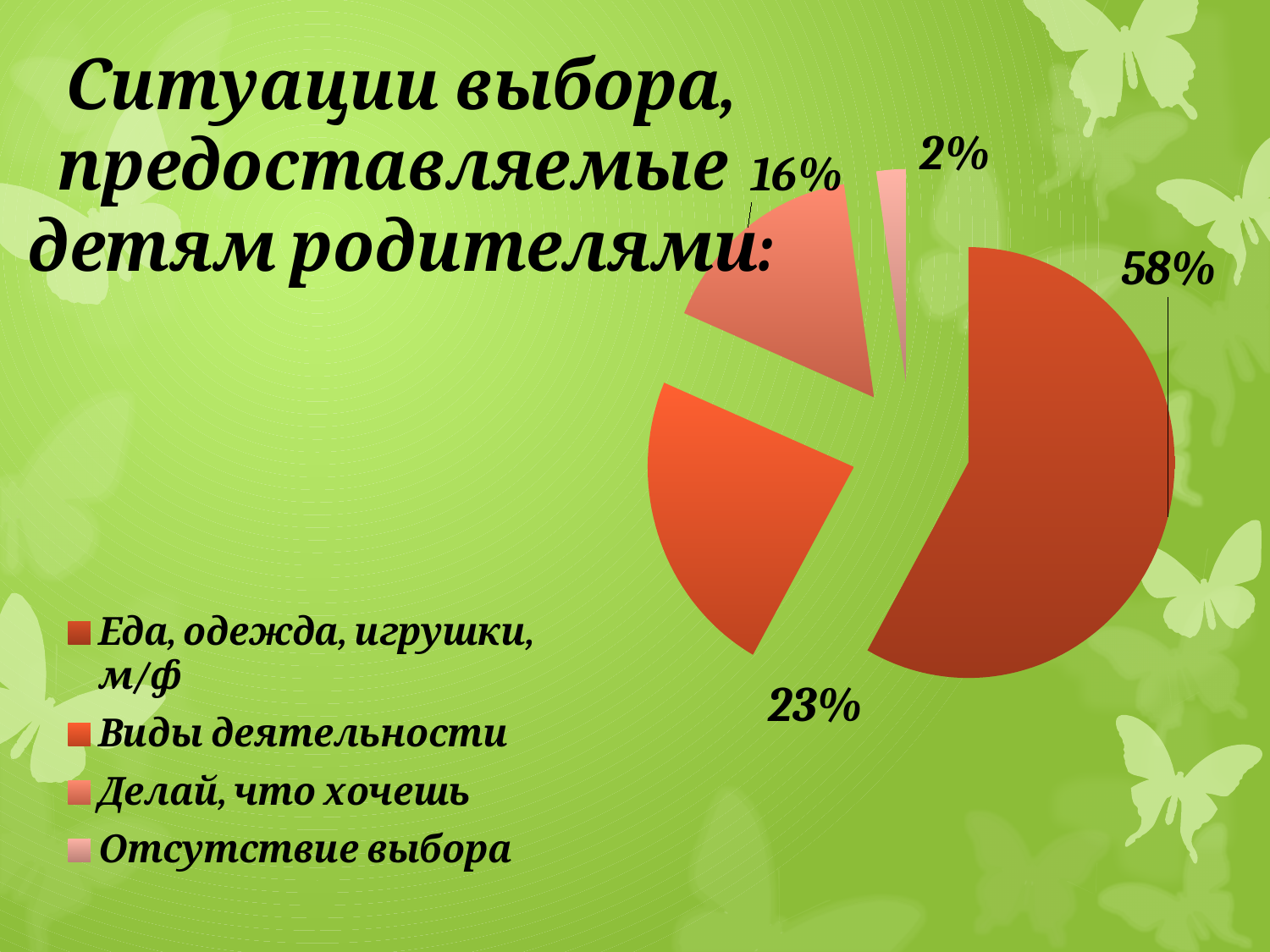
What share of the pie does "Отсутствие выбора" have? 2% What is the difference in percentage points between "Еда, одежда, игрушки, м/ф" and "Виды деятельности"? 35 Which is larger: the slice for "Виды деятельности" or the slice for "Делай, что хочешь"? Виды деятельности What share of the pie does "Виды деятельности" have? 23% What kind of chart is shown on the slide? Pie chart Which category has the smallest slice of the pie? Отсутствие выбора What share of the pie does "Делай, что хочешь" have? 16% What is the title of the slide containing the pie chart? Ситуации выбора, предоставляемые детям родителями: How many entries does the legend list? 4 How many slices does the pie chart have? 4 Which category has the largest slice of the pie? Еда, одежда, игрушки, м/ф What share of the pie does "Еда, одежда, игрушки, м/ф" have? 58%